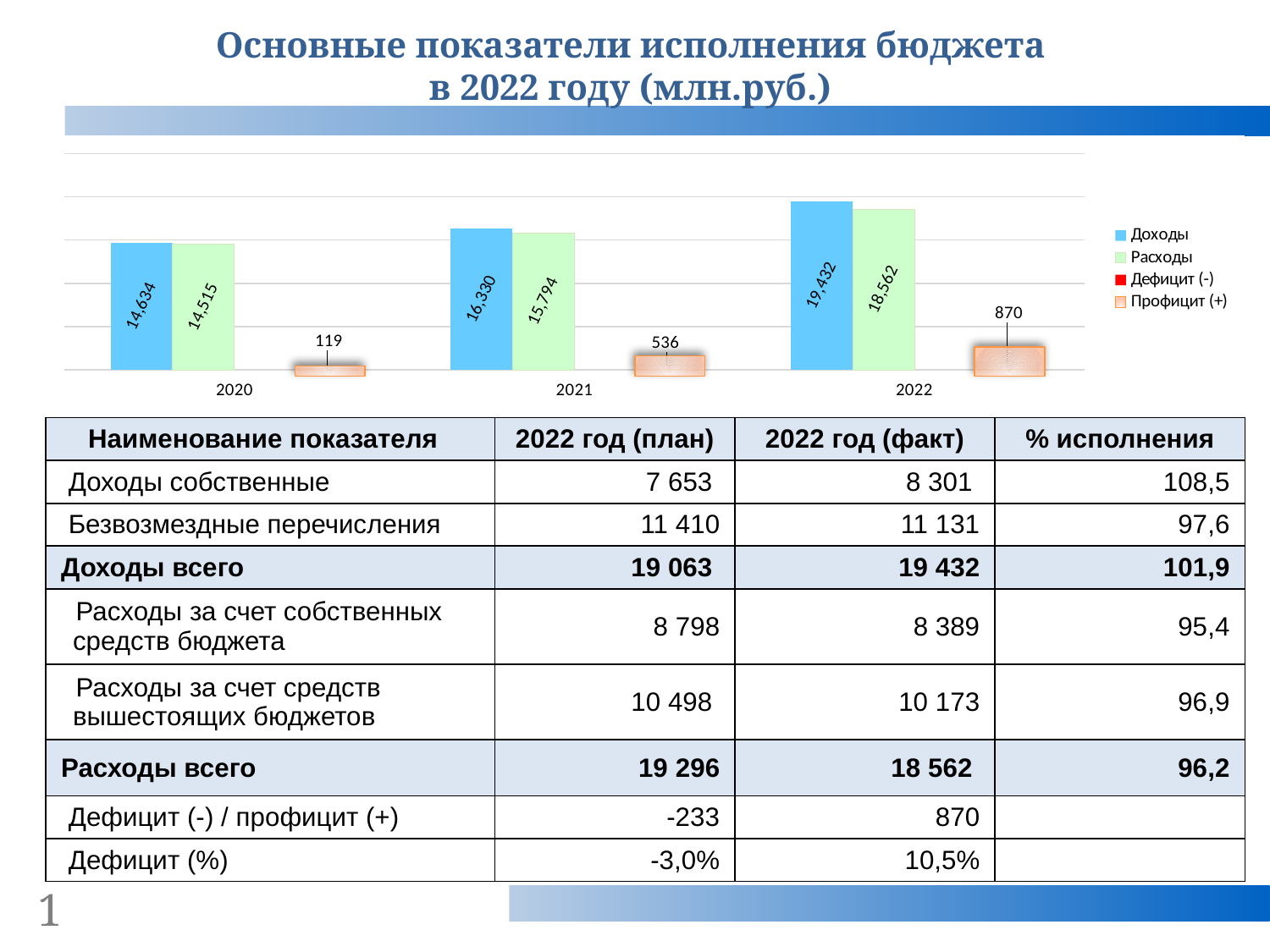
How many series does the chart legend list? 4 Which is larger in the chart: Расходы for 2020 or Расходы for 2021? Расходы for 2021 How many years (categories) are shown on the x axis of the chart? 3 What is the value of Доходы for 2022 in the chart? 19,432 Do the Доходы values rise or fall from 2020 to 2022 in the chart? Rise What kind of chart is shown on the slide? Bar chart What is the value of Расходы for 2021 in the chart? 15,794 In which year is Доходы highest in the chart? 2022 What is the value of Профицит (+) for 2020 in the chart? 119 In which year is Профицит (+) lowest in the chart? 2020 What is the difference between Доходы in 2022 and Доходы in 2020 in the chart? 4,798 What is the difference between Доходы and Расходы for 2021 in the chart? 536